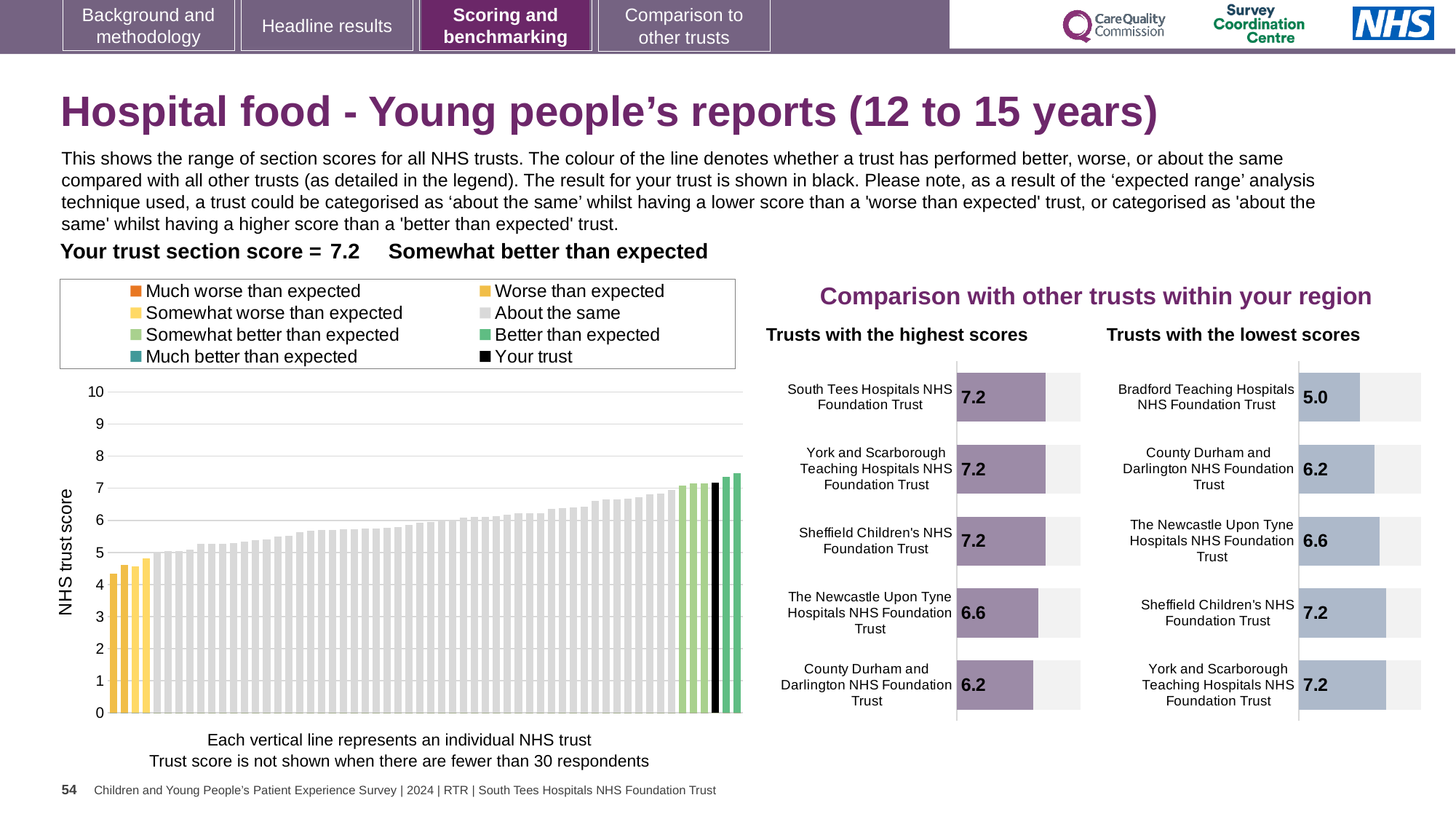
In the NHS trust score chart, do the trust scores rise or fall from left to right? rise In the 'Trusts with the highest scores' chart, what is the score for The Newcastle Upon Tyne Hospitals NHS Foundation Trust? 6.6 In the 'Trusts with the highest scores' chart, what is the difference between the scores of South Tees Hospitals NHS Foundation Trust and County Durham and Darlington NHS Foundation Trust? 1.0 In the NHS trust score chart, is the value for the black 'Your trust' bar greater or less than 7? greater In the 'Trusts with the lowest scores' chart, which trust has the lowest score? Bradford Teaching Hospitals NHS Foundation Trust How many entries does the legend of the NHS trust score chart list? 8 In the 'Trusts with the highest scores' chart, which trust has the lowest score? County Durham and Darlington NHS Foundation Trust In the 'Trusts with the highest scores' chart, what is the score for South Tees Hospitals NHS Foundation Trust? 7.2 How many trusts are shown in the 'Trusts with the lowest scores' chart? 5 In the 'Trusts with the lowest scores' chart, what is the difference between the scores of Sheffield Children's NHS Foundation Trust and Bradford Teaching Hospitals NHS Foundation Trust? 2.2 In the 'Trusts with the highest scores' chart, which has the higher score: The Newcastle Upon Tyne Hospitals NHS Foundation Trust or County Durham and Darlington NHS Foundation Trust? The Newcastle Upon Tyne Hospitals NHS Foundation Trust In the 'Trusts with the lowest scores' chart, what is the score for Bradford Teaching Hospitals NHS Foundation Trust? 5.0